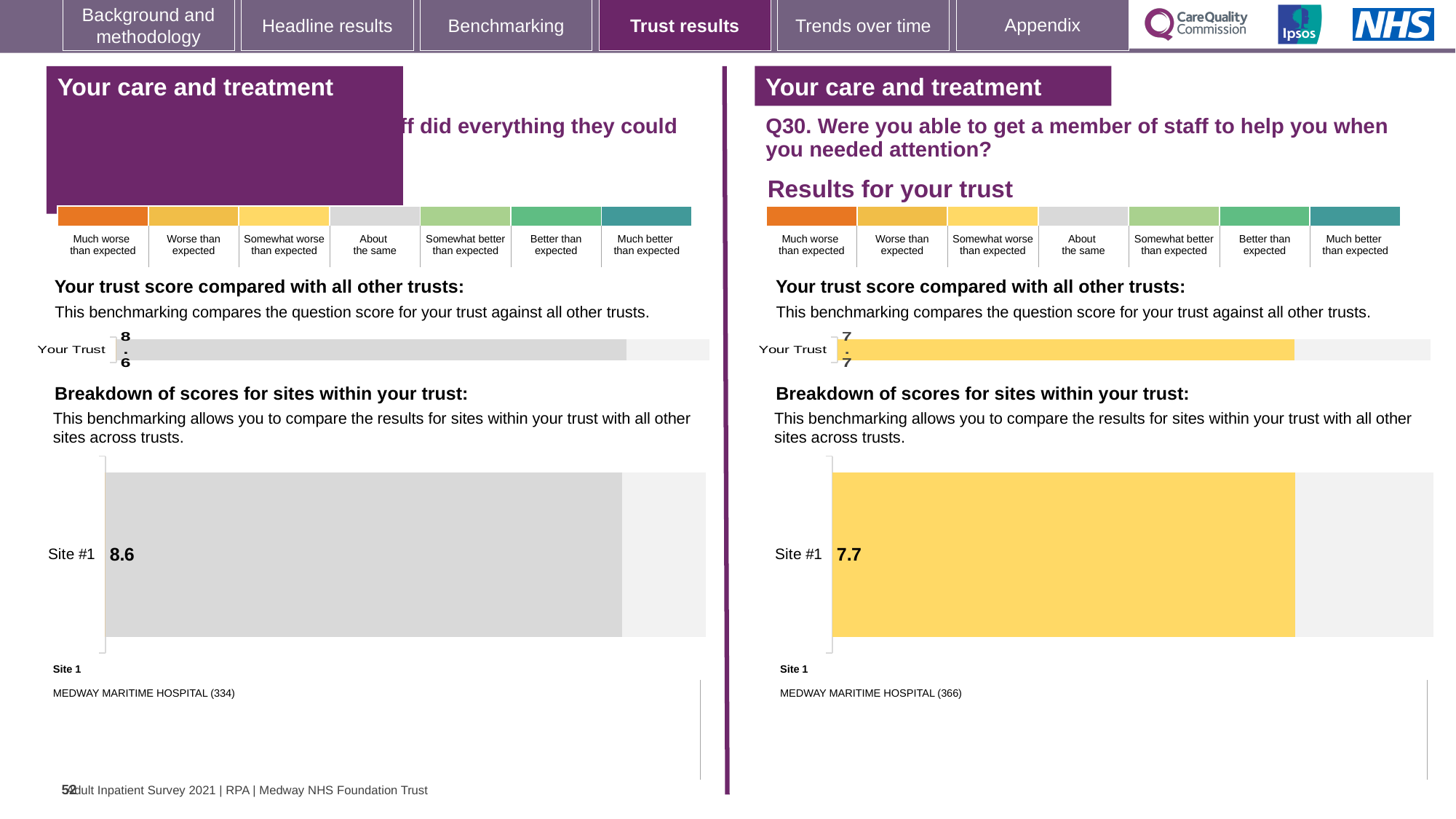
On the right-hand side (Q30), what is the trust score shown in the 'Your trust score compared with all other trusts' chart? 7.7 How many sites are shown in the left-hand breakdown of scores for sites chart? 1 On the right-hand side (Q30), what score is shown for Site #1 in the breakdown of scores for sites chart? 7.7 What type of chart is used for the Site #1 breakdown on the right-hand side (Q30)? Bar chart Which is larger: the Site #1 score in the left-hand breakdown chart or the Site #1 score in the right-hand (Q30) breakdown chart? Left-hand Site #1 (8.6) How many sites are shown in the right-hand (Q30) breakdown of scores for sites chart? 1 On the left-hand side, what is the trust score shown in the 'Your trust score compared with all other trusts' chart? 8.6 What type of chart is used to show 'Your Trust' score on the left-hand side? Bar chart On the right-hand side (Q30), which benchmark category does the yellow colour of the 'Your Trust' bar correspond to in the colour key? Somewhat worse than expected What is the difference between the Site #1 score on the left-hand breakdown chart and the Site #1 score on the right-hand (Q30) breakdown chart? 0.9 On the left-hand side, which benchmark category does the grey colour of the 'Your Trust' bar correspond to in the colour key? About the same On the left-hand side, what score is shown for Site #1 in the breakdown of scores for sites chart? 8.6